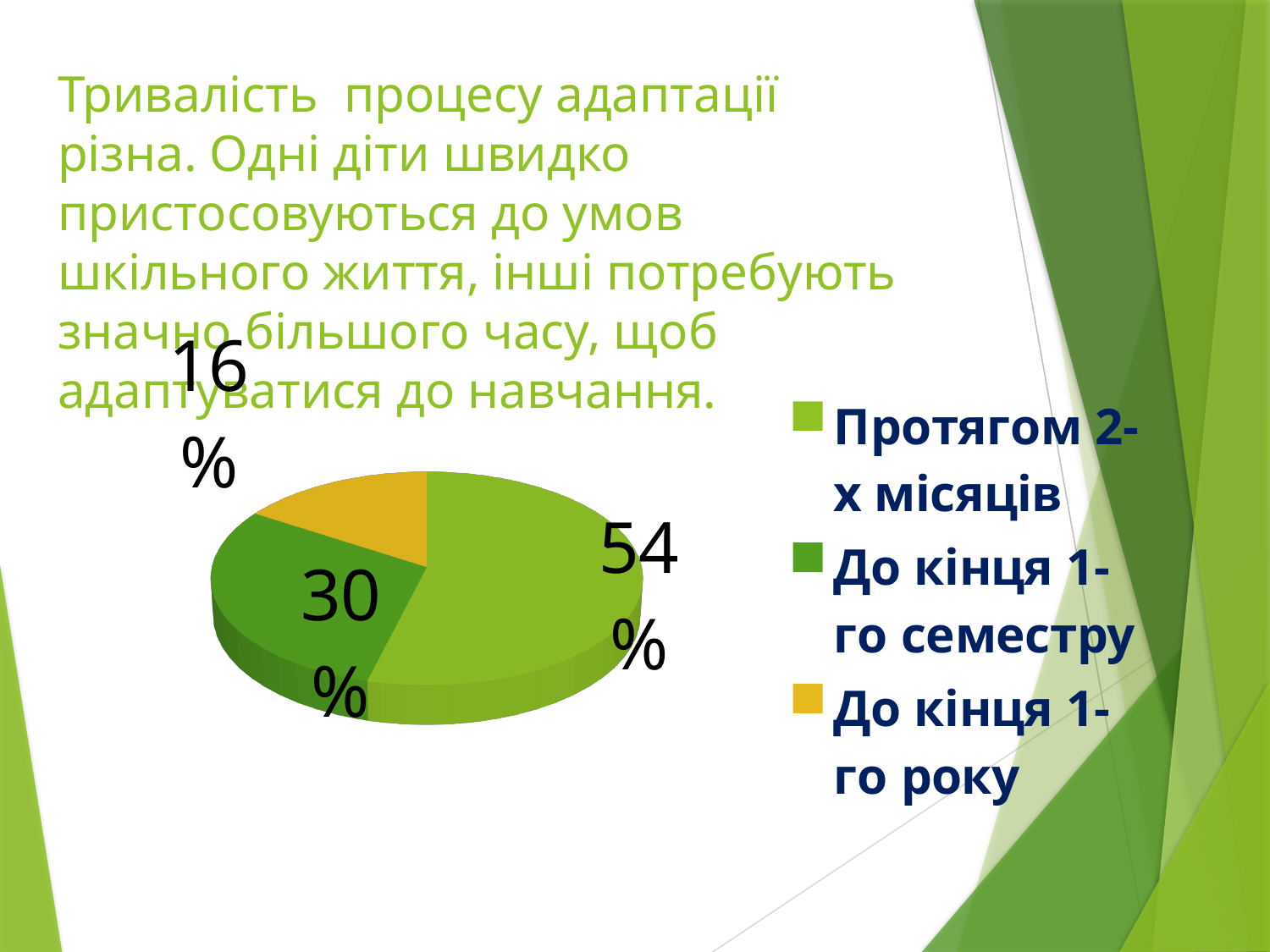
What is the difference between the shares for "До кінця 1-го семестру" and "До кінця 1-го року"? 14% Which is larger: the share for "До кінця 1-го семестру" or the share for "До кінця 1-го року"? До кінця 1-го семестру How many entries does the legend list? 3 Which category has the largest slice of the pie? Протягом 2-х місяців What colour is the slice for "До кінця 1-го року"? yellow What share of the pie does "До кінця 1-го семестру" have? 30% What share of the pie does "Протягом 2-х місяців" have? 54% What is the difference between the shares for "Протягом 2-х місяців" and "До кінця 1-го семестру"? 24% What kind of chart is shown on the slide? pie chart How many slices does the pie chart have? 3 What share of the pie does "До кінця 1-го року" have? 16% Which category has the smallest slice of the pie? До кінця 1-го року